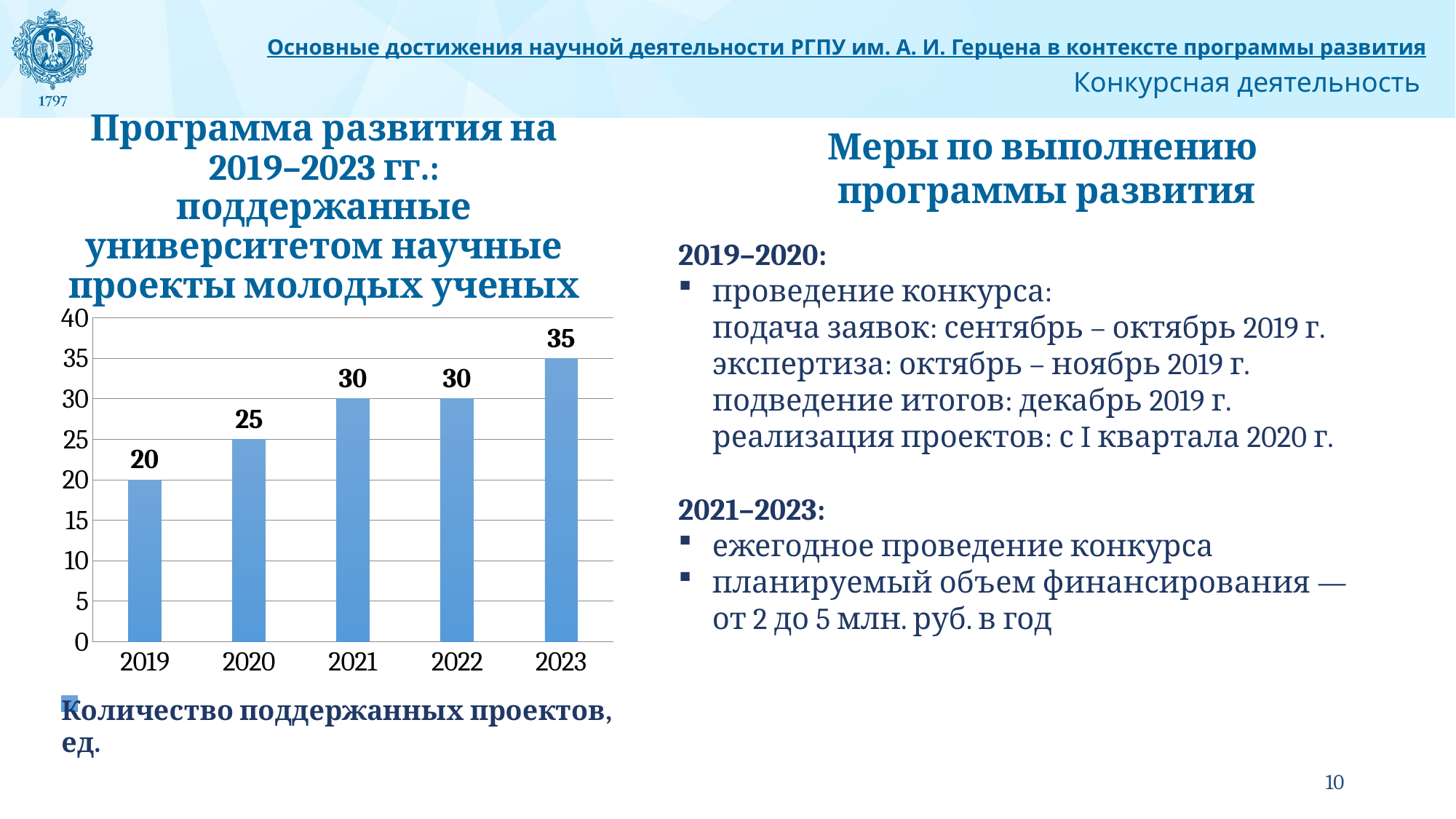
What kind of chart is shown on the slide? bar chart What is the difference between the values for 2020 and 2019? 5 Which year has the lowest number of supported projects? 2019 How many years are shown on the x axis of the chart? 5 What is the number of supported projects in 2023? 35 What is the difference between the values for 2023 and 2019? 15 What is the number of supported projects in 2019? 20 Which is larger, the value for 2020 or the value for 2022? 2022 What is the legend entry of the chart? Количество поддержанных проектов, ед. Do the values generally rise or fall from 2019 to 2023? rise What is the value shown for 2021? 30 Which year has the highest number of supported projects? 2023